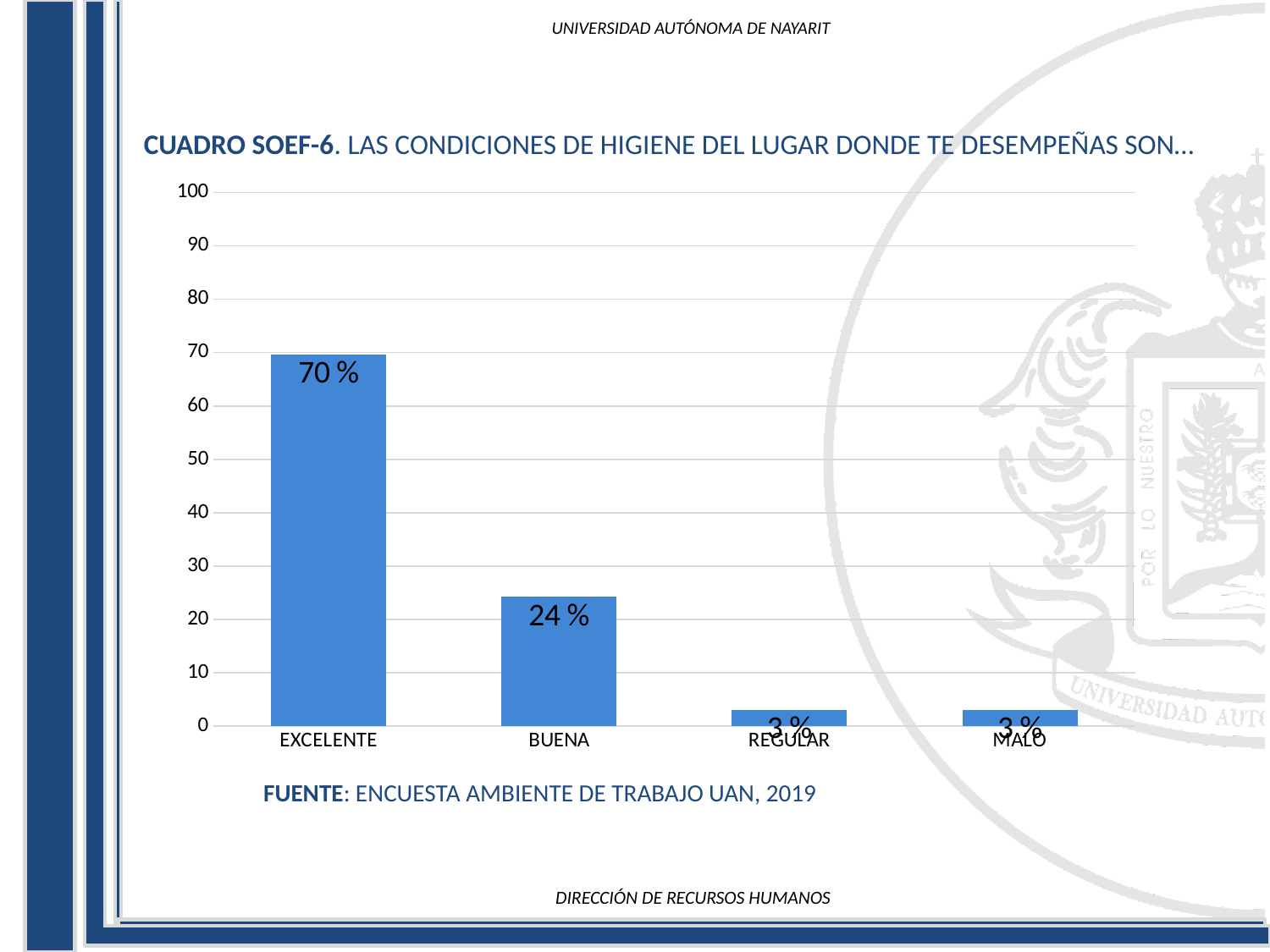
Which category has the highest value? EXCELENTE What value is shown for REGULAR? 3 % Is the value for EXCELENTE greater or less than 60? greater How many categories are shown on the x axis? 4 What is the difference between the values for EXCELENTE and BUENA? 46 % What value is shown for MALO? 3 % What value is shown for BUENA? 24 % Is the value for BUENA greater or less than 30? less What source is cited below the chart? ENCUESTA AMBIENTE DE TRABAJO UAN, 2019 What value is shown for EXCELENTE? 70 % Which is larger, the value for BUENA or the value for REGULAR? BUENA What kind of chart is shown on the slide? bar chart